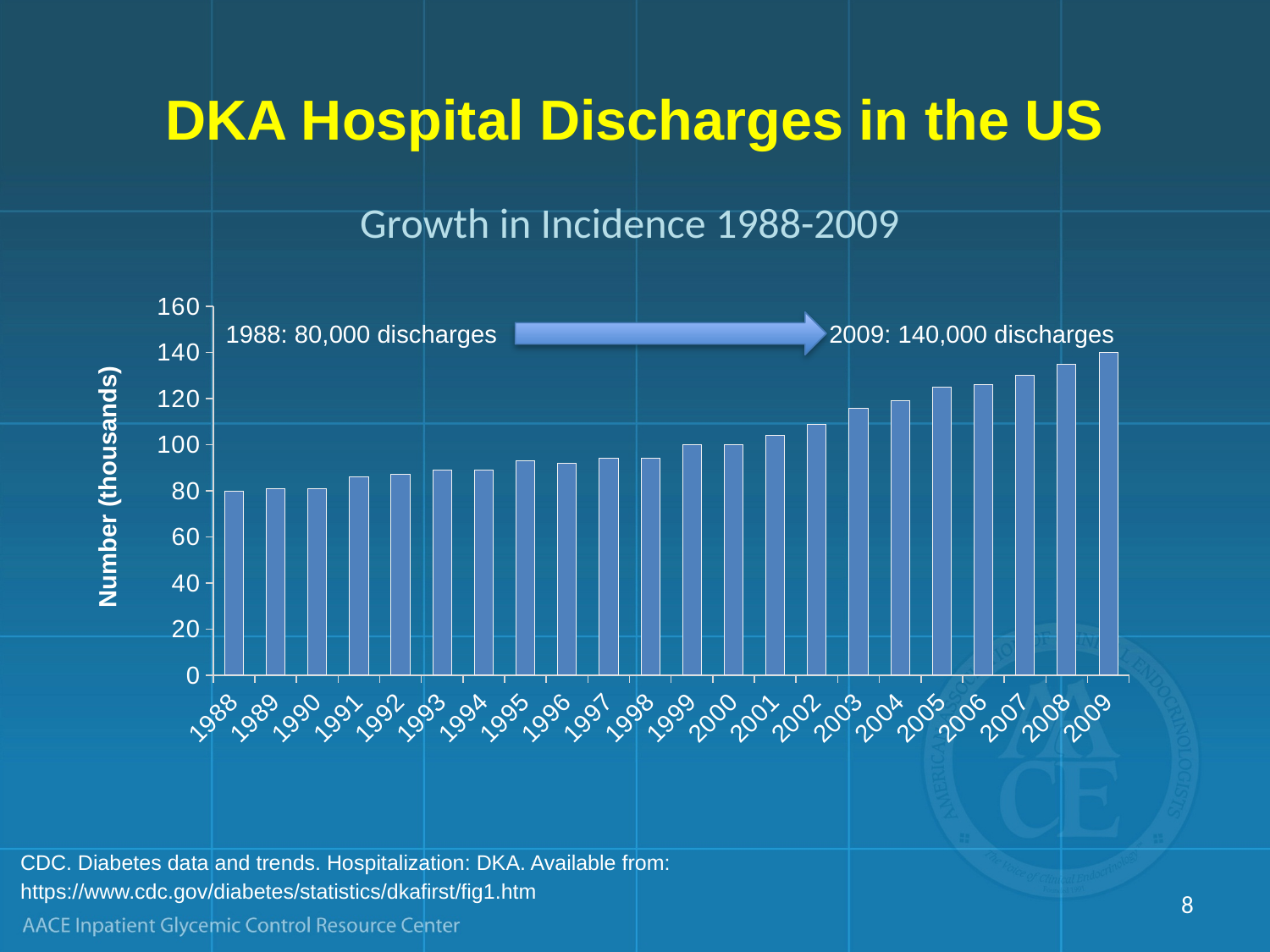
According to the annotation on the chart, how many DKA hospital discharges were there in 1988? 80,000 Do the values generally rise or fall from 1988 to 2009? rise What kind of chart is shown on the slide? bar chart By how much did the number of discharges increase from 1988 to 2009? 60,000 Is the value for 1993 greater or less than 100 (thousands)? less Which year has the highest number of discharges? 2009 How many years (bars) are plotted in the chart? 22 What is the title of the vertical axis? Number (thousands) Which year has the larger value, 1995 or 2005? 2005 Which year has the lowest number of discharges? 1988 According to the annotation on the chart, how many DKA hospital discharges were there in 2009? 140,000 Is the value for 2004 greater or less than 100 (thousands)? greater